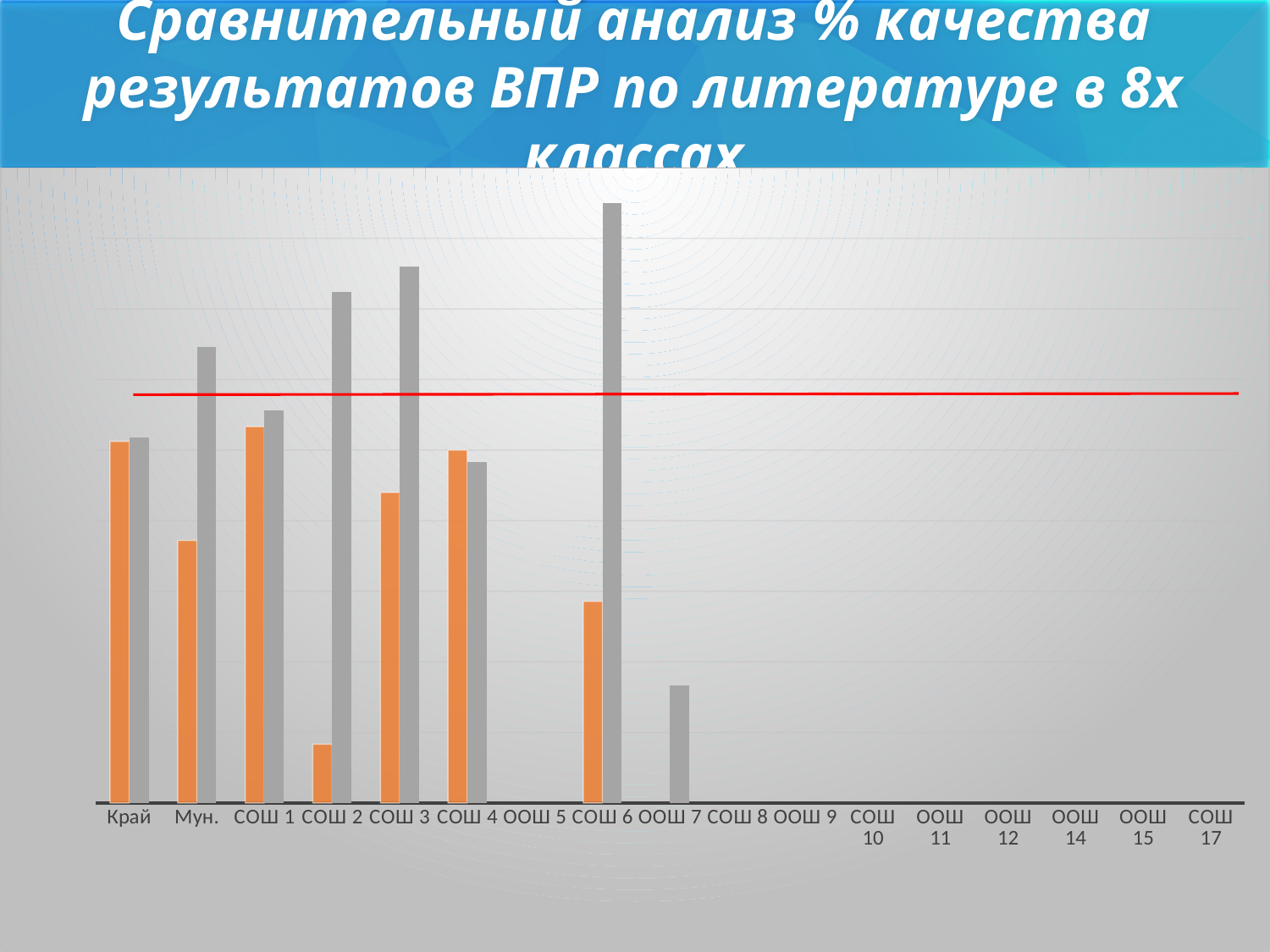
What kind of chart is shown on the slide? Bar chart Which category has the tallest grey bar in the chart? СОШ 6 How many categories are labelled along the x axis of the chart? 17 Is the orange bar for Край taller or shorter than the orange bar for Мун.? Taller Which category has the tallest orange bar in the chart? СОШ 1 Is the grey bar for СОШ 2 taller or shorter than the grey bar for СОШ 1? Taller Which category has the shortest orange bar in the chart? СОШ 2 Is the grey bar for СОШ 3 taller or shorter than the grey bar for СОШ 6? Shorter What two colours are used for the bars in the chart? Orange and grey Which is the last category labelled on the x axis of the chart? СОШ 17